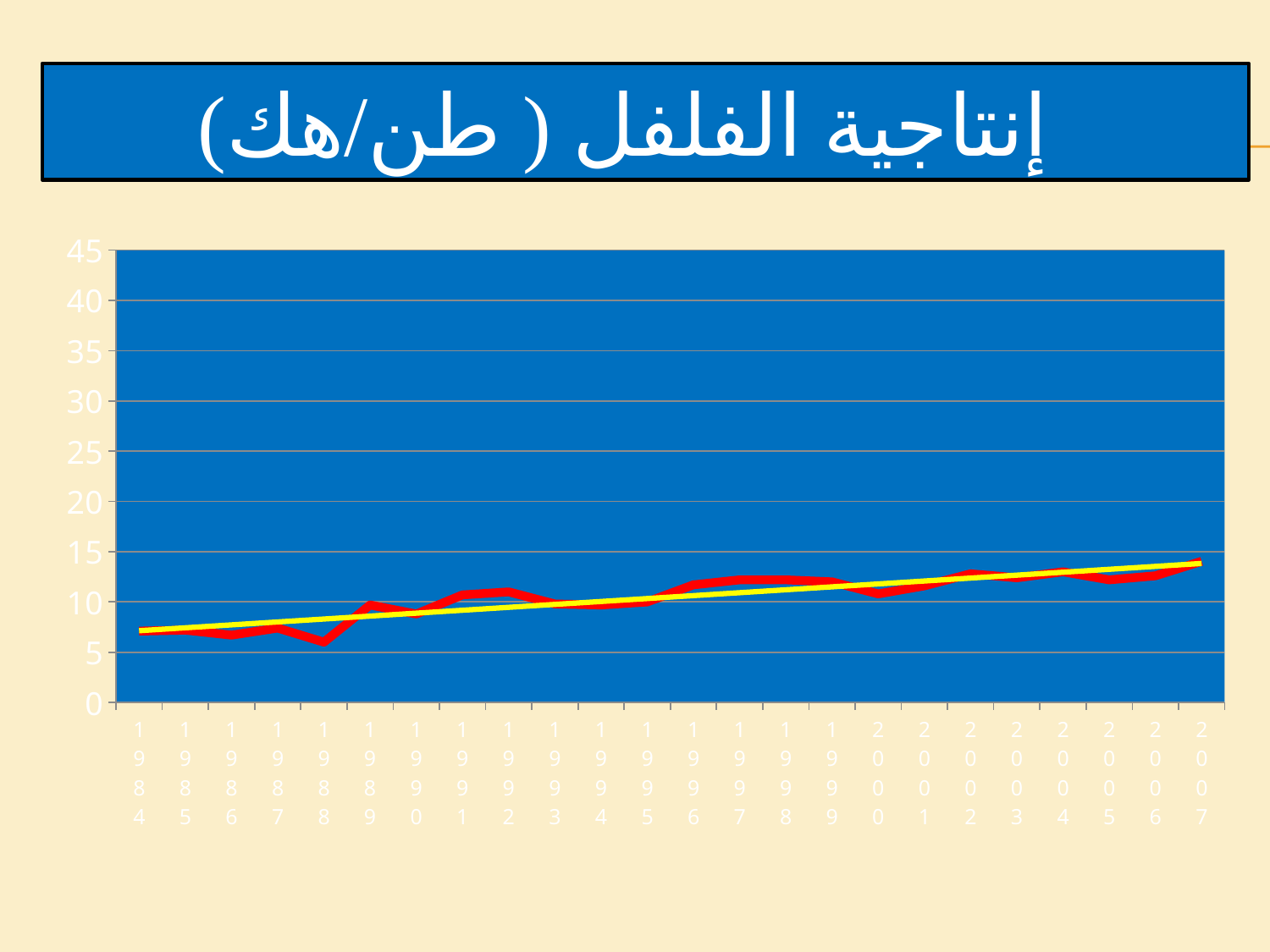
Which is larger, the red line value for 1984 or for 2007? 2007 Is the value of the red line for 2003 greater or less than 20? less Which is larger, the red line value for 1988 or for 1995? 1995 What is the title of the chart? إنتاجية الفلفل ( طن/هك) Is the value of the red line for 1988 greater or less than 10? less How many years are plotted along the x axis of the chart? 24 Do the values of the red line generally rise or fall from 1984 to 2007? rise Is the value of the red line for 1984 greater or less than 10? less In which year does the red line reach its lowest value? 1988 What kind of chart is shown on the slide? line chart What is the first year shown on the x axis? 1984